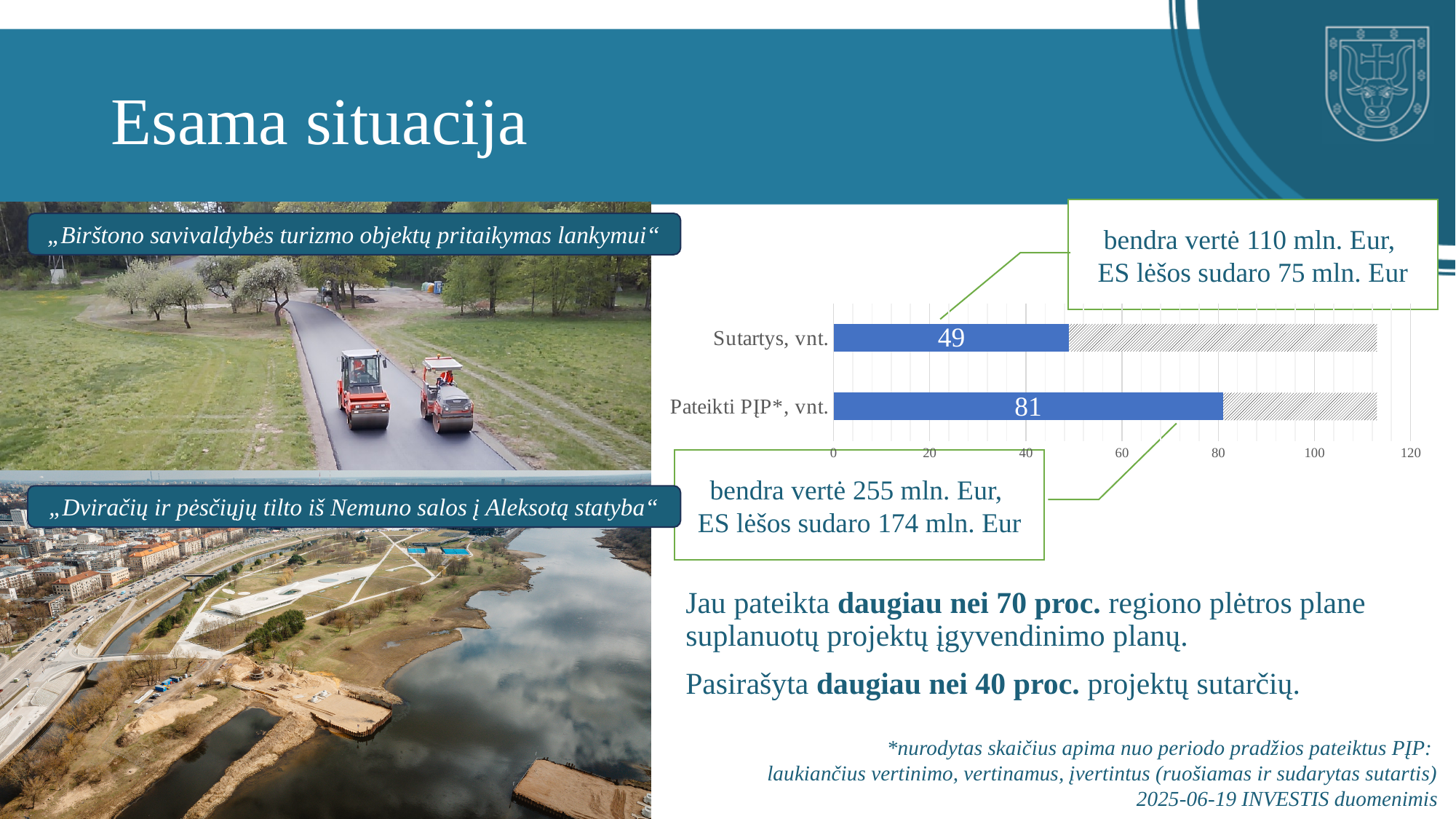
Which category has the lower value in the chart? Sutartys, vnt. What is the difference between the values for "Pateikti PĮP*, vnt." and "Sutartys, vnt."? 32 What type of chart is shown on the slide? bar chart Which category has the higher value in the chart? Pateikti PĮP*, vnt. How many categories are shown in the chart? 2 According to the callout attached to the "Sutartys, vnt." bar, what is the total value (bendra vertė) of the contracts? 110 mln. Eur What is the value for "Sutartys, vnt." in the chart? 49 What is the maximum value shown on the chart's horizontal axis? 120 What is the value for "Pateikti PĮP*, vnt." in the chart? 81 Is the value for "Sutartys, vnt." greater or less than 60? less Is the value for "Pateikti PĮP*, vnt." greater or less than 80? greater Is the value for "Sutartys, vnt." larger or smaller than the value for "Pateikti PĮP*, vnt."? smaller